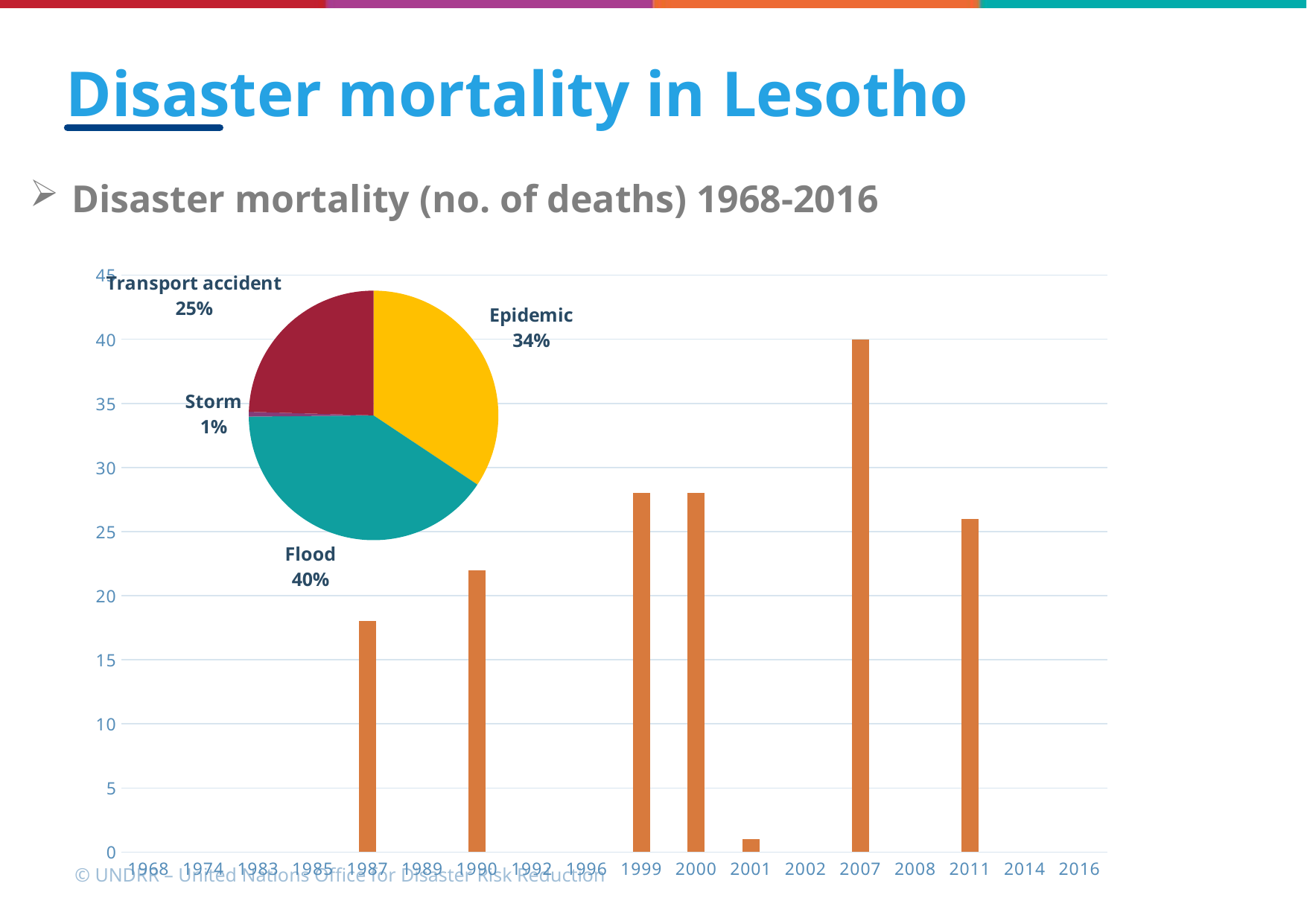
In the pie chart, which disaster type has the smallest share of deaths? Storm In the pie chart, what share of disaster deaths is attributed to Flood? 40% In the bar chart of disaster mortality 1968-2016, is the value for 2011 greater or less than 25? greater In the pie chart, which disaster type has the largest share of deaths? Flood In the bar chart of disaster mortality 1968-2016, which year has the highest number of deaths? 2007 In the bar chart of disaster mortality 1968-2016, is the value for 1987 greater or less than 20? less In the bar chart of disaster mortality 1968-2016, which is larger, the value for 1990 or the value for 1999? 1999 In the pie chart, what share of disaster deaths is attributed to Transport accident? 25% In the pie chart, what share of disaster deaths is attributed to Storm? 1% How many slices does the pie chart have? 4 In the pie chart, how many percentage points larger is the Flood share than the Transport accident share? 15